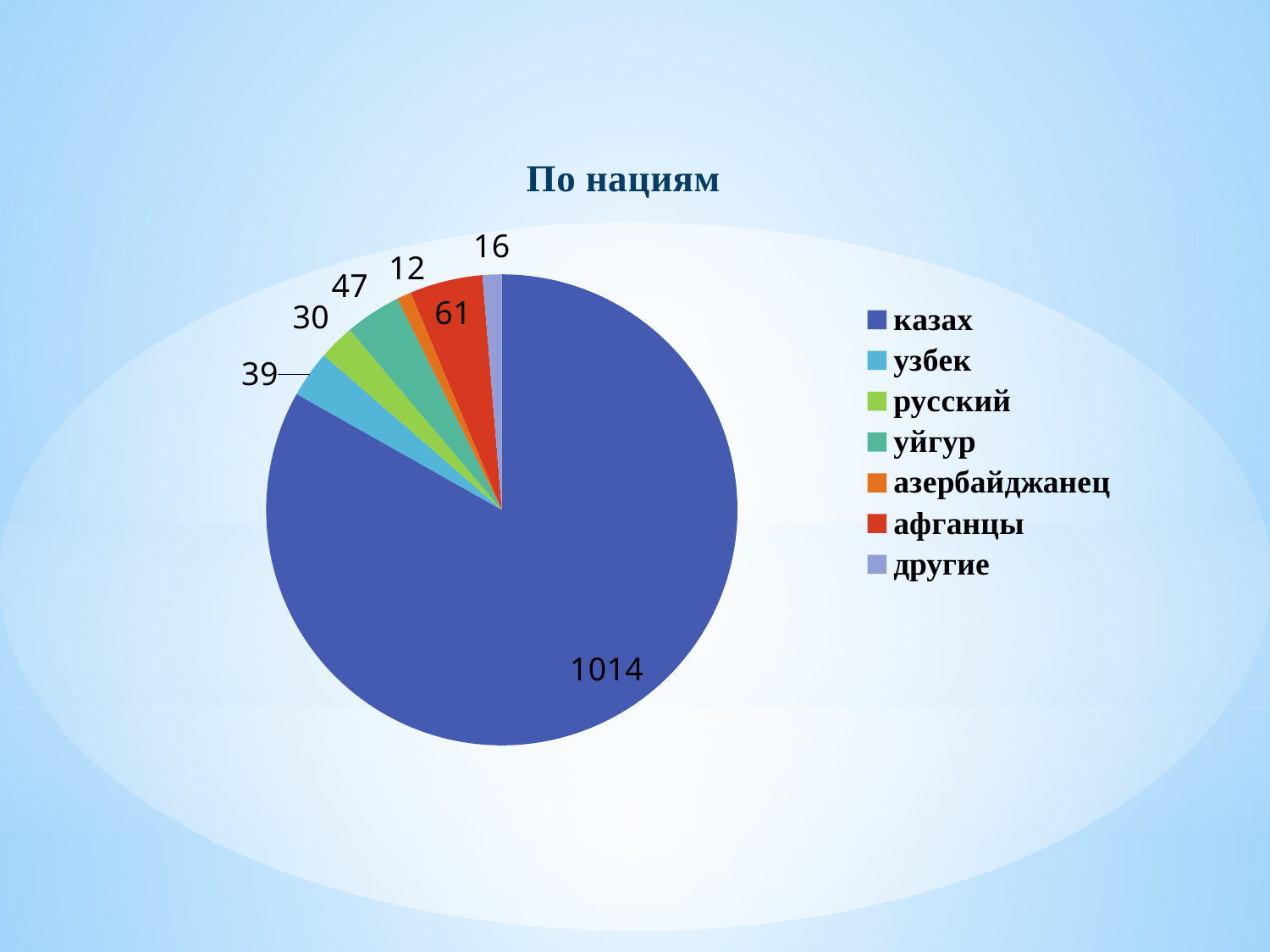
What is the value for азербайджанец? 12 What is the title of the chart? По нациям What is the value for афганцы? 61 Which category has the smallest slice? азербайджанец Which is larger, the value for уйгур or the value for русский? уйгур How many categories does the legend list? 7 Which category has the largest slice? казах What is the difference between the values for афганцы and узбек? 22 What is the value for уйгур? 47 What colour is the slice for другие? light purple What type of chart is shown on the slide? pie chart What is the value for казах? 1014